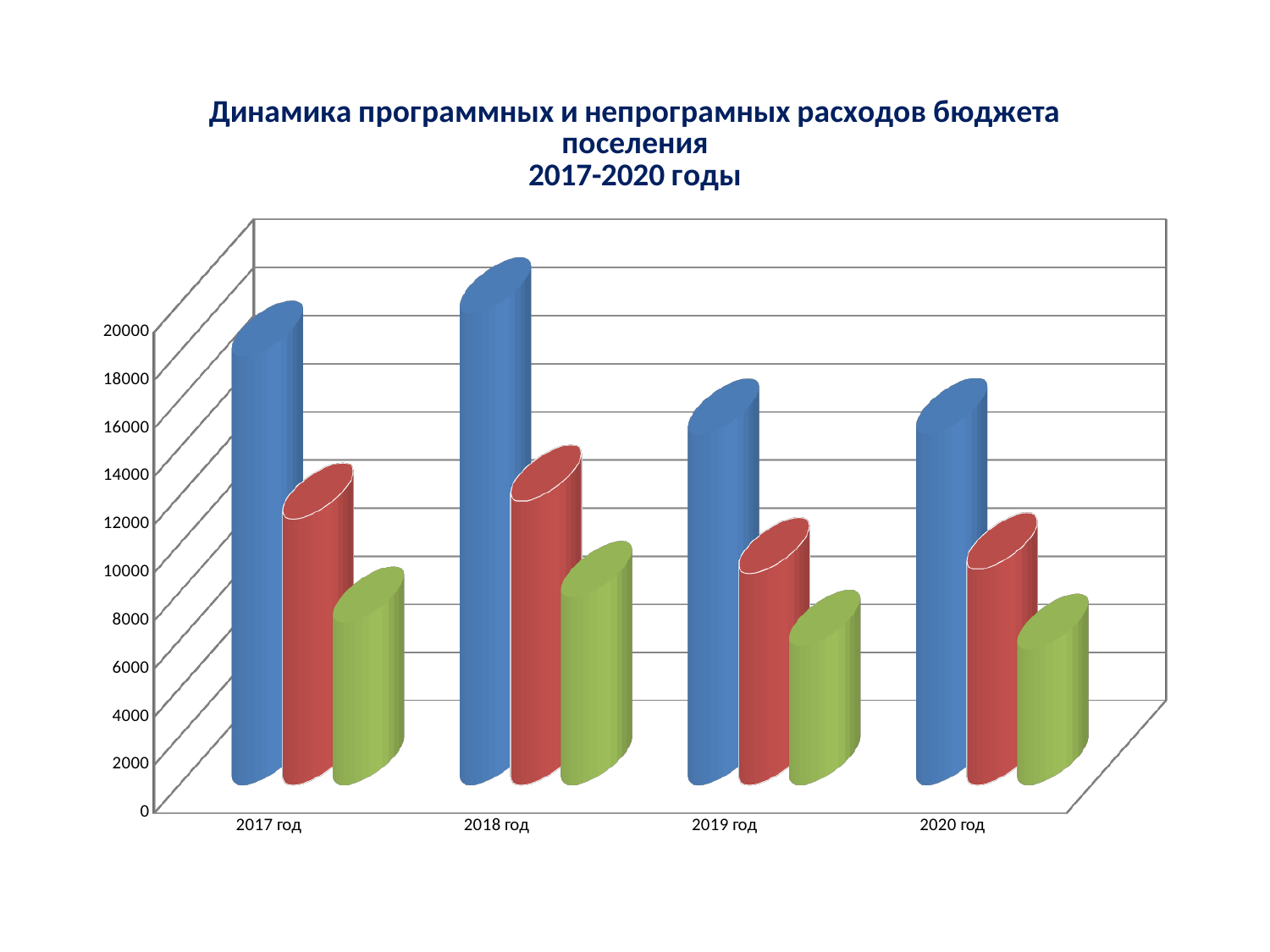
What kind of chart is shown on the slide? bar chart What colour is the tallest bar in each year group? blue Is the red bar for 2017 год greater or less than 16000? less How many year categories are shown on the x axis? 4 Which is larger, the green bar for 2018 год or the green bar for 2019 год? 2018 год In which year is the blue bar the tallest? 2018 год How many bars are plotted for each year? 3 Is the green bar for 2019 год greater or less than 12000? less Does the blue bar rise or fall from 2018 год to 2019 год? fall Which is larger, the blue bar for 2018 год or the blue bar for 2019 год? 2018 год What is the title of the chart? Динамика программных и непрограмных расходов бюджета поселения 2017-2020 годы